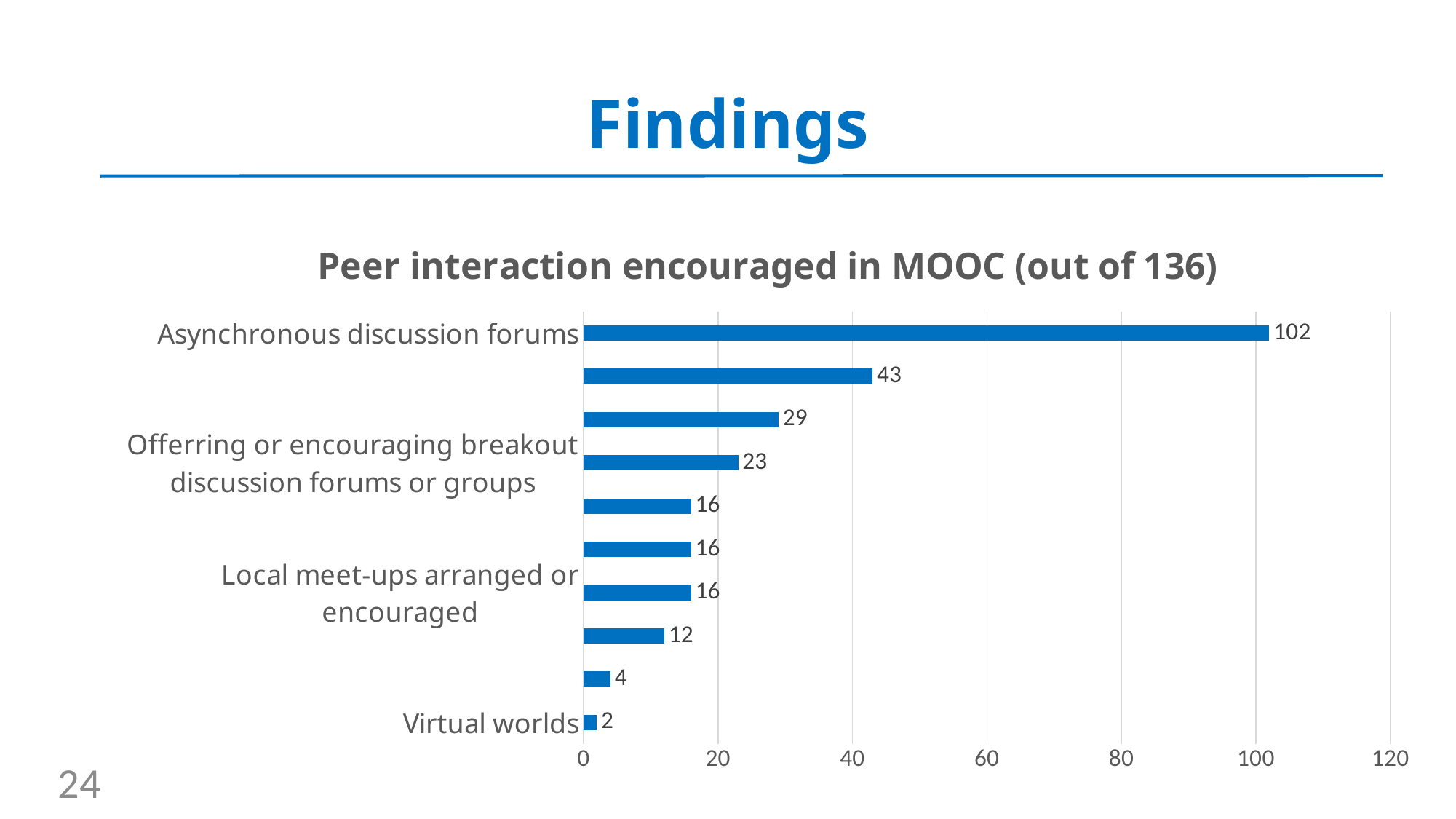
What is the value for Asynchronous discussion forums? 102 What is the difference between the values for Asynchronous discussion forums and Offerring or encouraging breakout discussion forums or groups? 79 What is the value for Local meet-ups arranged or encouraged? 16 Which category has the lowest value? Virtual worlds What is the value for Offerring or encouraging breakout discussion forums or groups? 23 Which is larger, the value for Offerring or encouraging breakout discussion forums or groups or the value for Local meet-ups arranged or encouraged? Offerring or encouraging breakout discussion forums or groups What is the value for Virtual worlds? 2 What is the title of the chart? Peer interaction encouraged in MOOC (out of 136) Is the value for Asynchronous discussion forums greater or less than 100? greater What is the difference between the values for Asynchronous discussion forums and Virtual worlds? 100 Which category has the highest value? Asynchronous discussion forums How many bars are plotted in the chart? 10